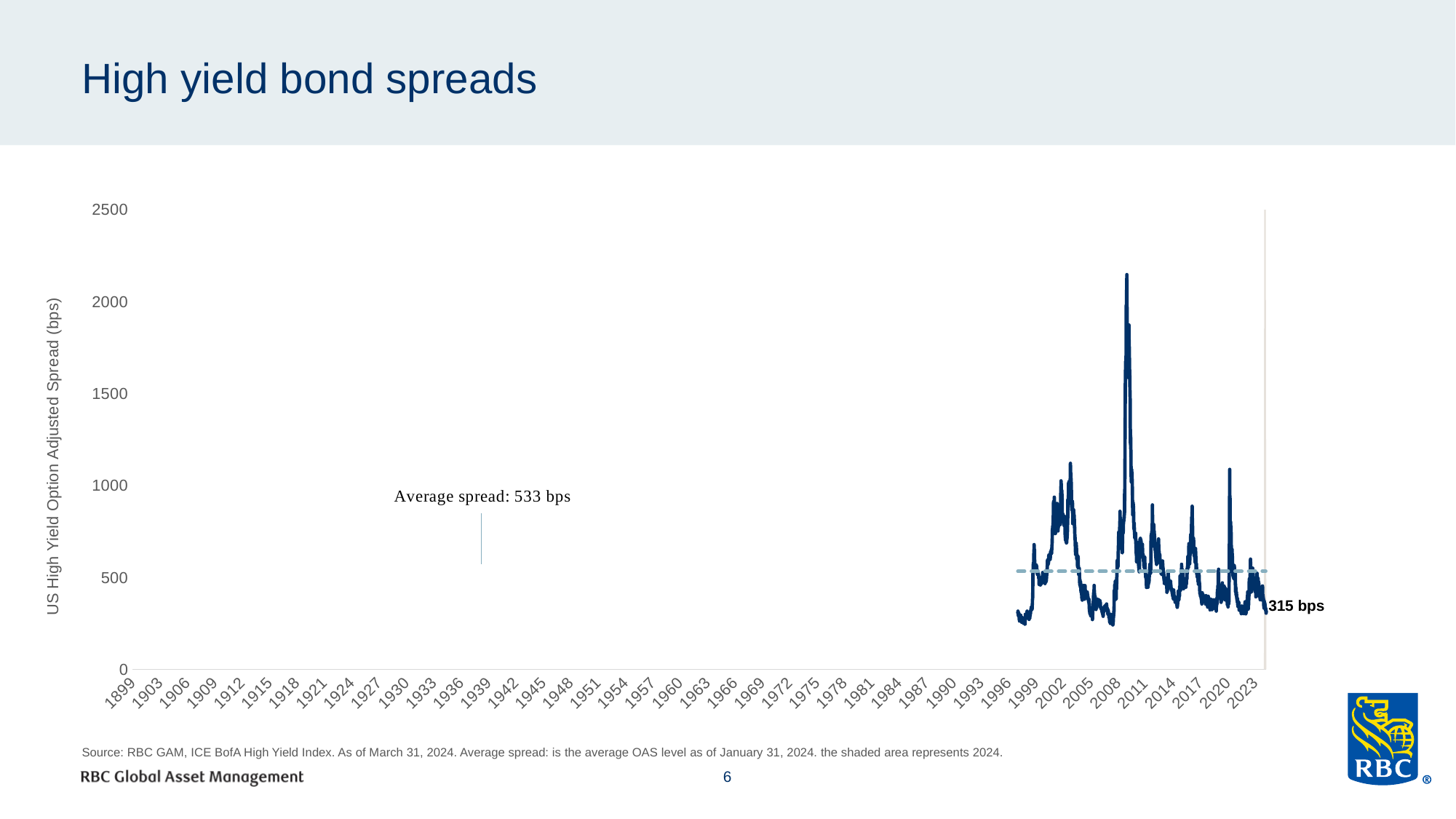
Around which year does the spread reach its highest level on the chart? 2008 Is the peak spread reached around 2008-2009 greater or less than 2000? greater By how many basis points is the latest spread of 315 bps below the average spread of 533 bps? 218 bps Is the average spread shown by the dashed line greater or less than 500? greater Which is larger, the average spread or the latest spread of 315 bps? the average spread What is the most recent value of the US high yield option adjusted spread labelled on the chart? 315 bps Is the spike in spreads around 2020 greater or less than 1500? less What is the label on the vertical axis of the chart? US High Yield Option Adjusted Spread (bps) What is the highest tick value shown on the vertical axis? 2500 What kind of chart is shown on the slide? line chart What average spread is annotated on the chart? 533 bps